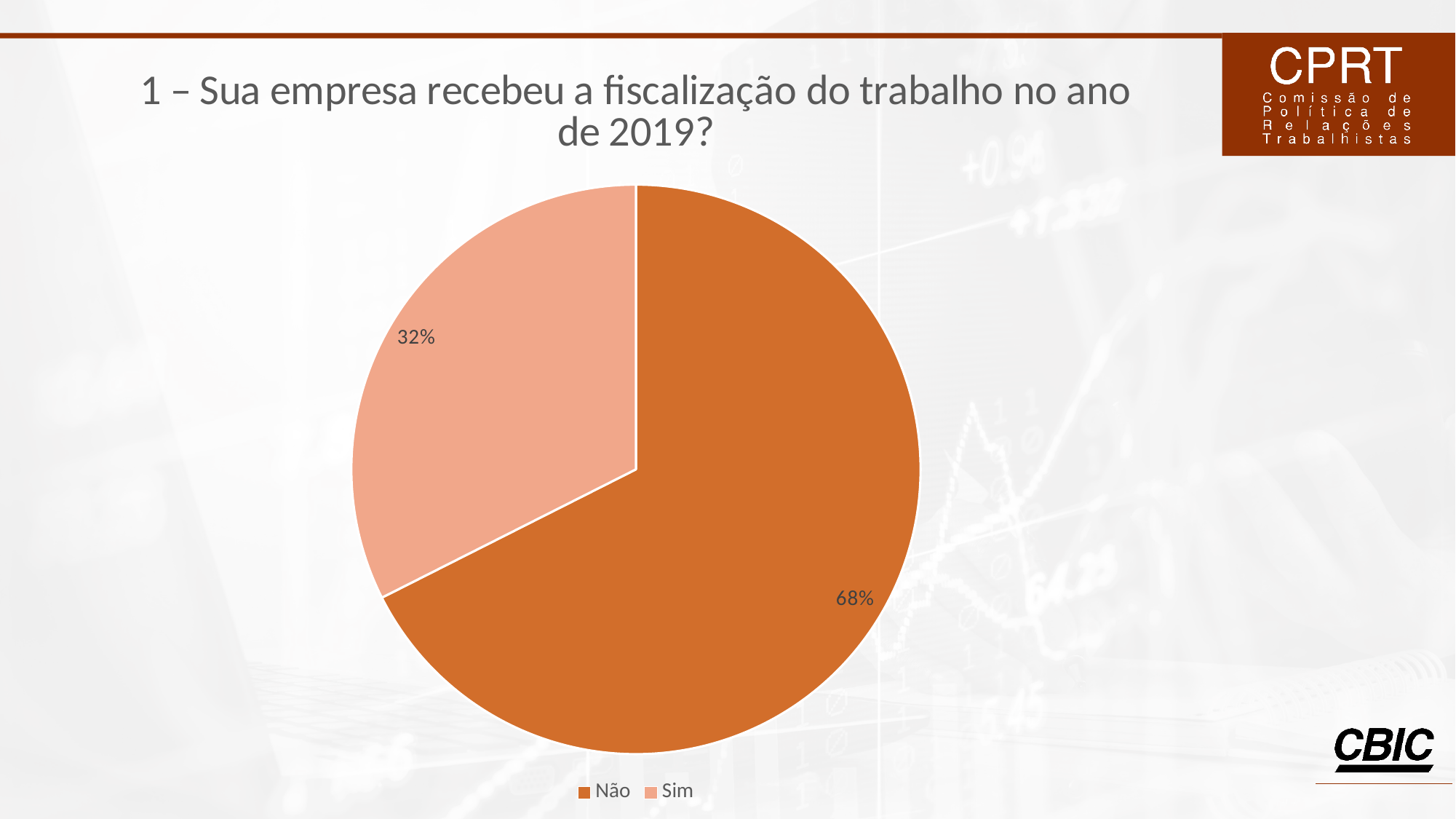
How many entries does the legend list? 2 Which slice is the smallest in the pie chart? Sim What share of the pie does the "Não" slice represent? 68% What kind of chart is shown on the slide? Pie chart Which is larger, the "Sim" slice or the "Não" slice? Não What is the title of the chart on the slide? 1 – Sua empresa recebeu a fiscalização do trabalho no ano de 2019? What share of the pie does the "Sim" slice represent? 32% How many slices does the pie chart have? 2 Which legend entry is shown in the lighter orange colour? Sim What is the difference in percentage points between the "Não" and "Sim" slices? 36 Which slice is the largest in the pie chart? Não